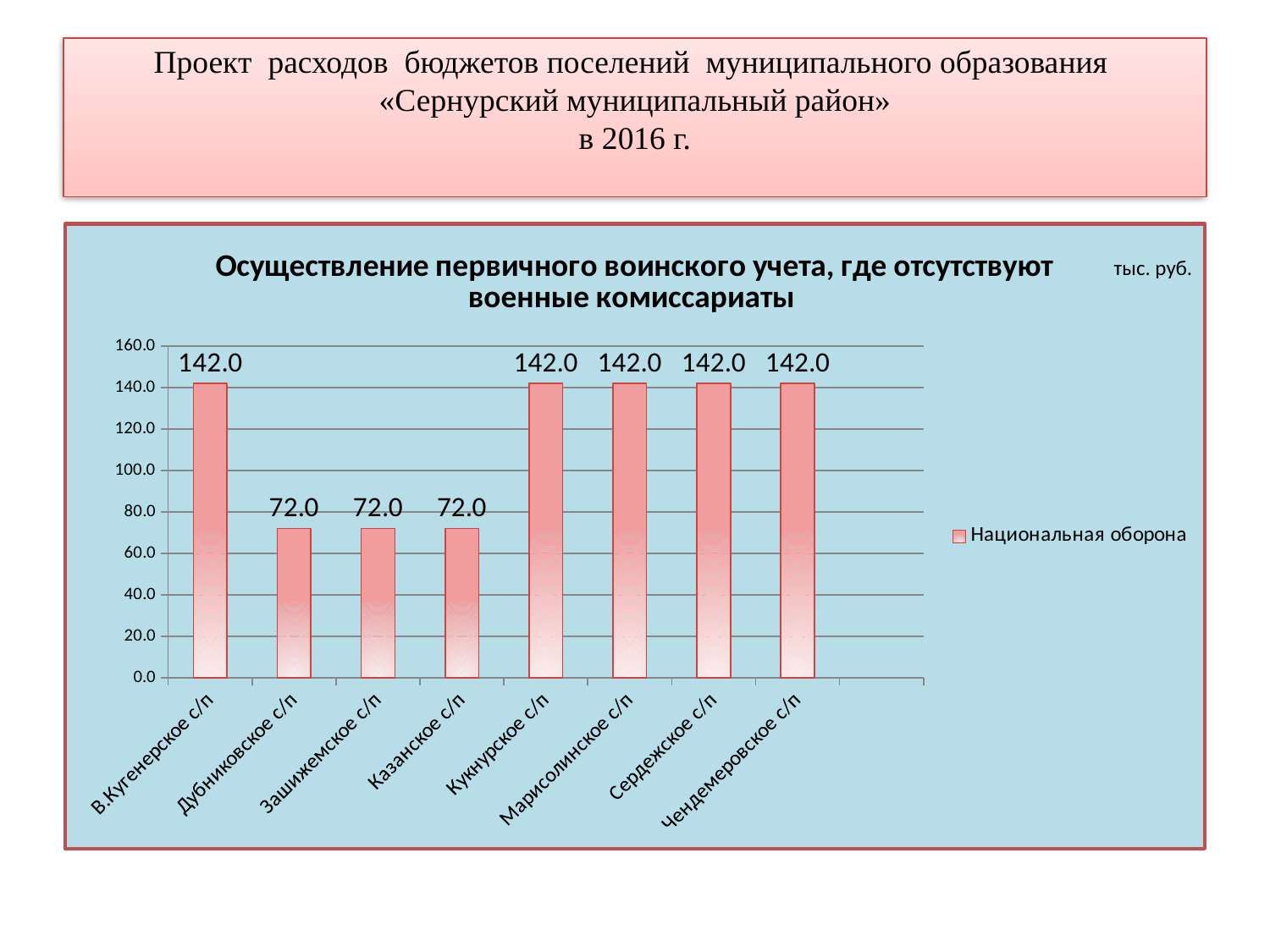
What is the value for Кукнурское с/п? 142.0 Is the value for Сердежское с/п greater or less than 100.0? greater What is the value for Чендемеровское с/п? 142.0 How many categories are shown on the x axis? 8 What is the difference between the values for В.Кугенерское с/п and Зашижемское с/п? 70.0 What kind of chart is shown on the slide? bar chart What series name is shown in the legend? Национальная оборона What is the value for Казанское с/п? 72.0 What unit is indicated next to the chart title? тыс. руб. Which is larger, the value for Марисолинское с/п or the value for Дубниковское с/п? Марисолинское с/п How many series does the legend list? 1 What is the value for Дубниковское с/п? 72.0